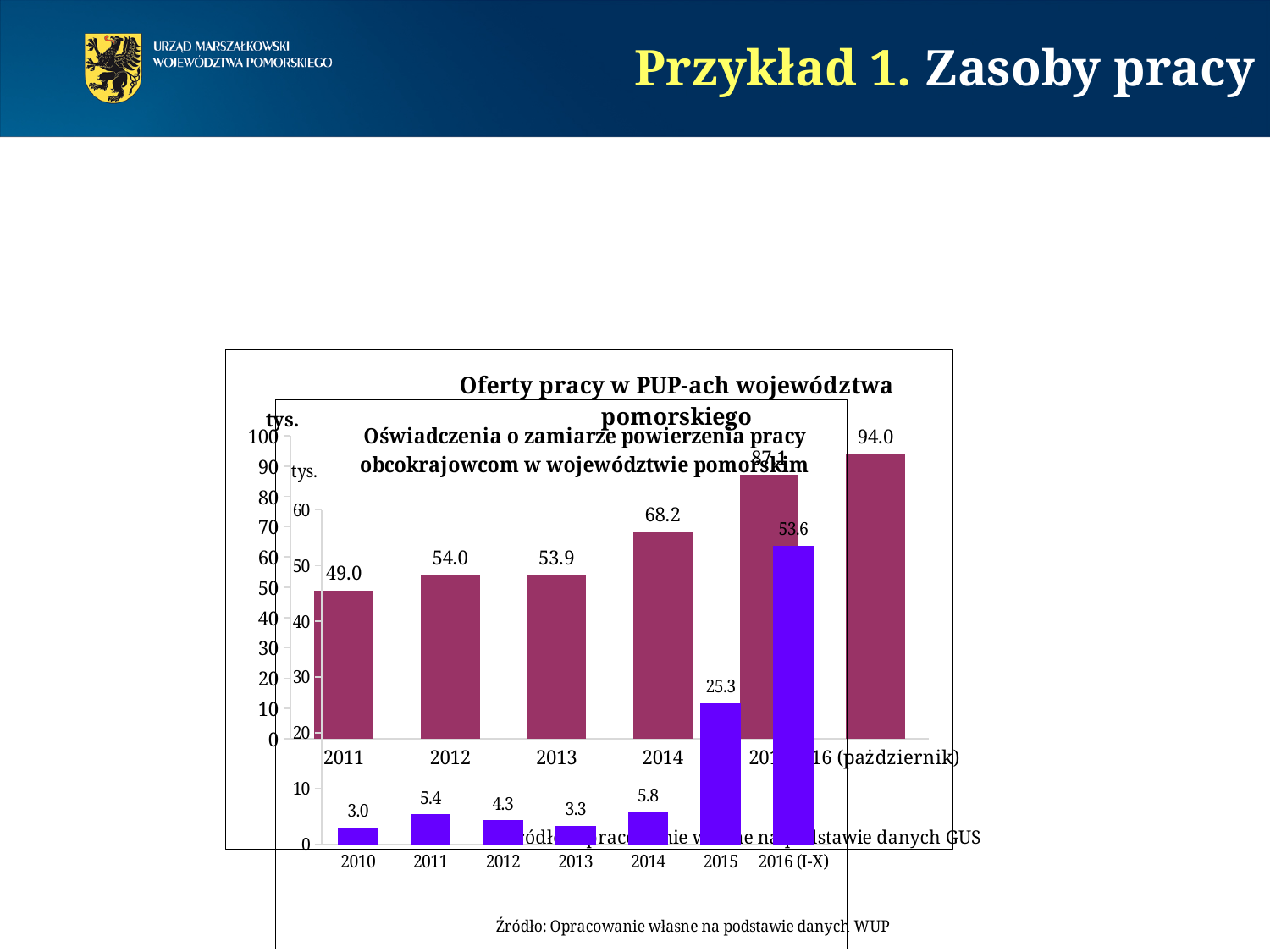
In the chart 'Oświadczenia o zamiarze powierzenia pracy obcokrajowcom w województwie pomorskim', what is the value for 2016 (I-X)? 53.6 In the chart 'Oferty pracy w PUP-ach województwa pomorskiego', what is the value for 2014? 68.2 In the chart 'Oferty pracy w PUP-ach województwa pomorskiego', which year has the lowest value? 2011 In the chart 'Oświadczenia o zamiarze powierzenia pracy obcokrajowcom w województwie pomorskim', what is the value for 2015? 25.3 In the chart 'Oferty pracy w PUP-ach województwa pomorskiego', do the values generally rise or fall from 2011 to 2016? rise In the chart 'Oświadczenia o zamiarze powierzenia pracy obcokrajowcom w województwie pomorskim', what is the difference between the values for 2016 (I-X) and 2015? 28.3 In the chart 'Oferty pracy w PUP-ach województwa pomorskiego', what is the difference between the values for 2012 and 2011? 5.0 In the chart 'Oświadczenia o zamiarze powierzenia pracy obcokrajowcom w województwie pomorskim', which year has the lowest value? 2010 In the chart 'Oświadczenia o zamiarze powierzenia pracy obcokrajowcom w województwie pomorskim', how many years are shown on the x axis? 7 In the chart 'Oferty pracy w PUP-ach województwa pomorskiego', what is the value for 2016 (październik)? 94.0 In the chart 'Oświadczenia o zamiarze powierzenia pracy obcokrajowcom w województwie pomorskim', which year has the highest value? 2016 (I-X) What kind of chart is 'Oferty pracy w PUP-ach województwa pomorskiego'? bar chart